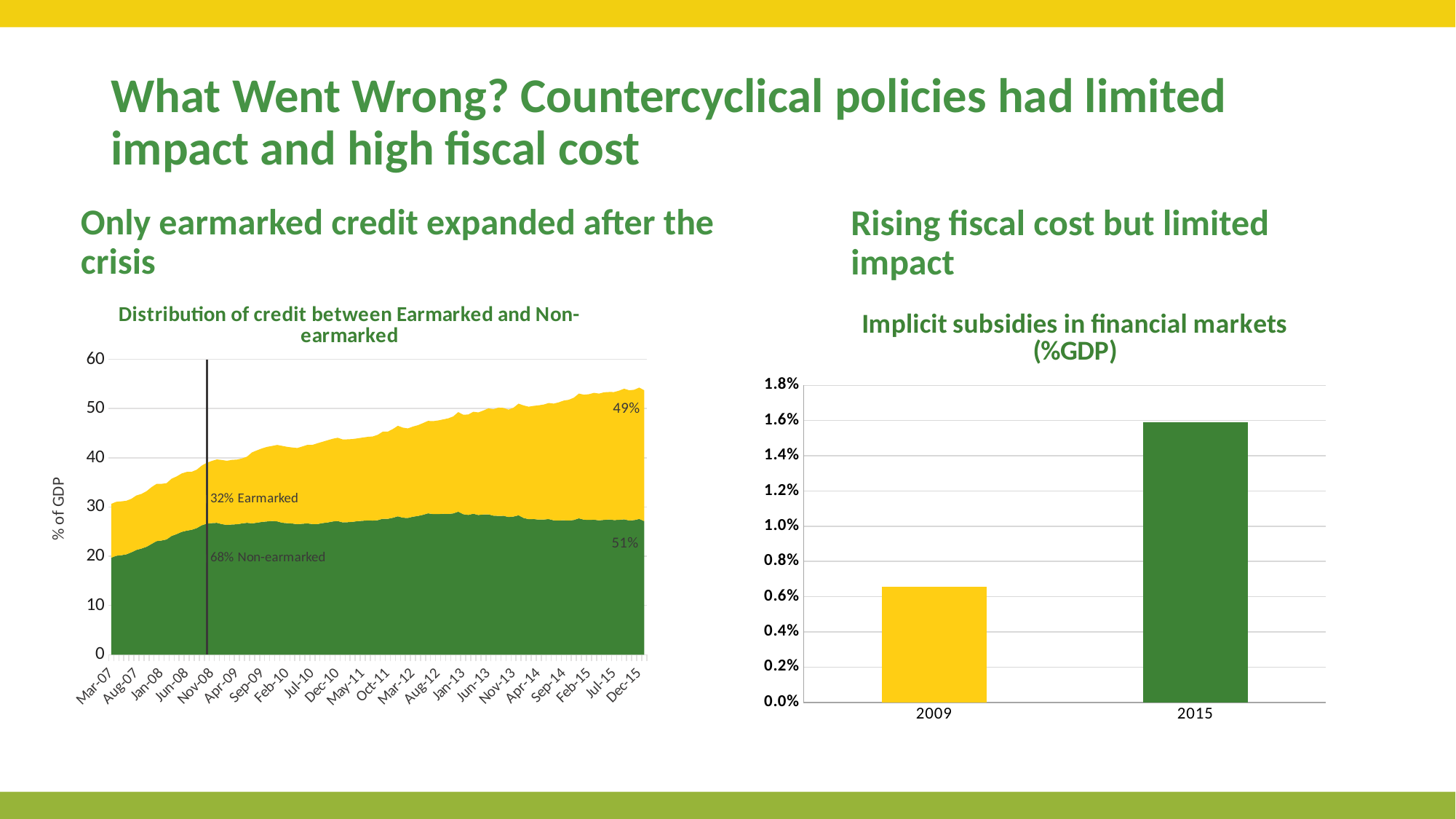
What kind of chart is the 'Implicit subsidies in financial markets (%GDP)' chart? bar chart In the 'Distribution of credit between Earmarked and Non-earmarked' chart, what share of credit was earmarked at the point marked by the vertical line (Nov-08)? 32% In the 'Distribution of credit between Earmarked and Non-earmarked' chart, what share of credit was non-earmarked at the point marked by the vertical line (Nov-08)? 68% In the 'Distribution of credit between Earmarked and Non-earmarked' chart, does total credit as % of GDP rise or fall from Mar-07 to Dec-15? rise In the 'Implicit subsidies in financial markets (%GDP)' chart, which year has the higher value? 2015 In the 'Implicit subsidies in financial markets (%GDP)' chart, is the value for 2015 greater or less than 1.4%? greater In the 'Distribution of credit between Earmarked and Non-earmarked' chart, what is the label on the vertical axis? % of GDP In the 'Distribution of credit between Earmarked and Non-earmarked' chart, what share is labelled for the earmarked (yellow) area at the end of the series (Dec-15)? 49% In the 'Implicit subsidies in financial markets (%GDP)' chart, is the value for 2009 greater or less than 0.8%? less What kind of chart is the 'Distribution of credit between Earmarked and Non-earmarked' chart? area chart In the 'Implicit subsidies in financial markets (%GDP)' chart, how many years are shown? 2 In the 'Implicit subsidies in financial markets (%GDP)' chart, is the value for 2015 larger or smaller than the value for 2009? larger